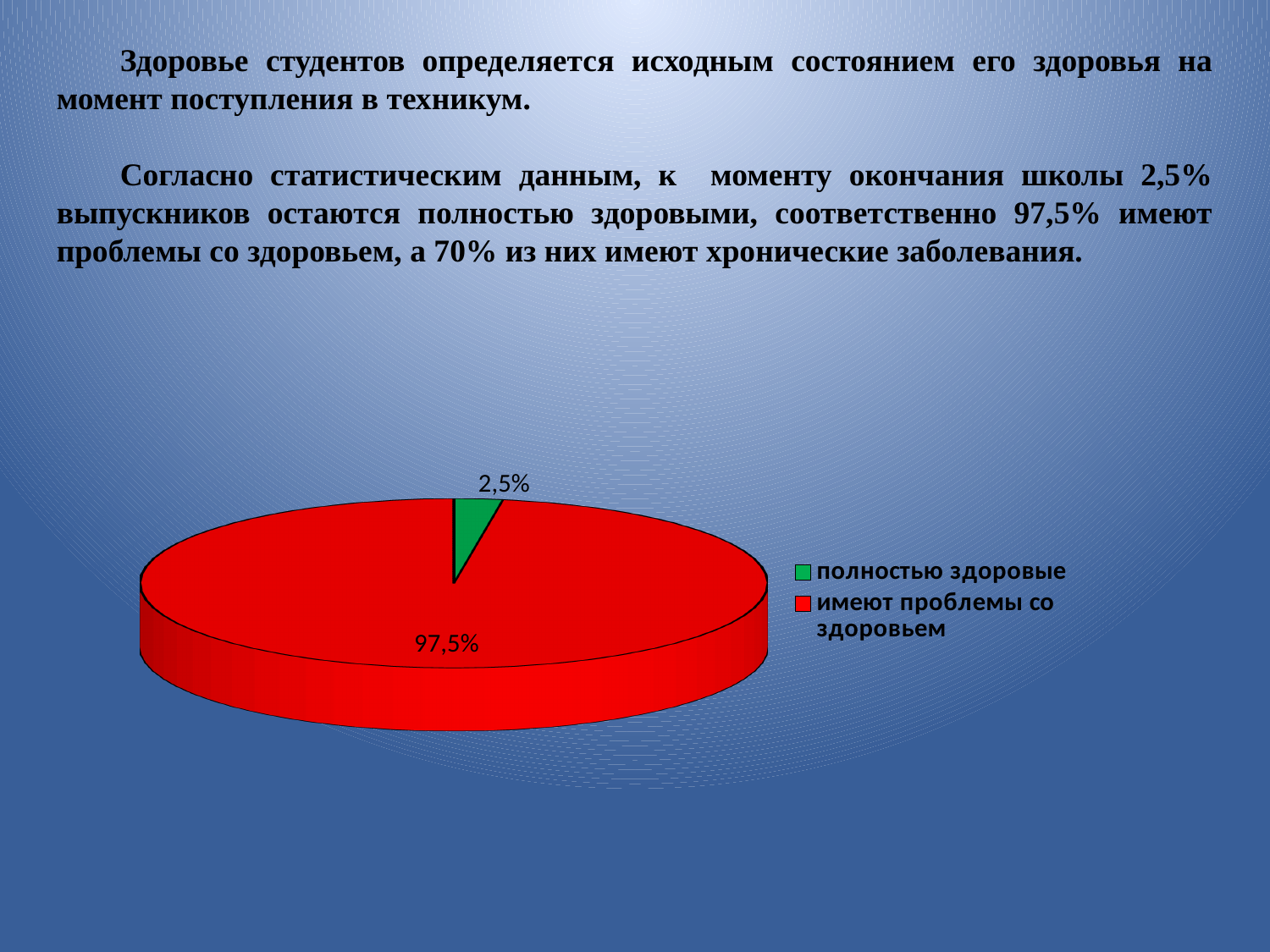
What kind of chart is shown on the slide? pie chart Which category has the largest slice of the pie? имеют проблемы со здоровьем What is the value for "полностью здоровые"? 2,5% Which category has the smallest slice of the pie? полностью здоровые What colour is the slice for "имеют проблемы со здоровьем"? red What is the difference between the values for "имеют проблемы со здоровьем" and "полностью здоровые"? 95% What is the value for "имеют проблемы со здоровьем"? 97,5% What share of the pie does "полностью здоровые" take? 2,5% How many slices does the pie chart have? 2 Which is larger: the slice for "полностью здоровые" or the slice for "имеют проблемы со здоровьем"? имеют проблемы со здоровьем How many entries does the legend list? 2 What colour is the slice for "полностью здоровые"? green